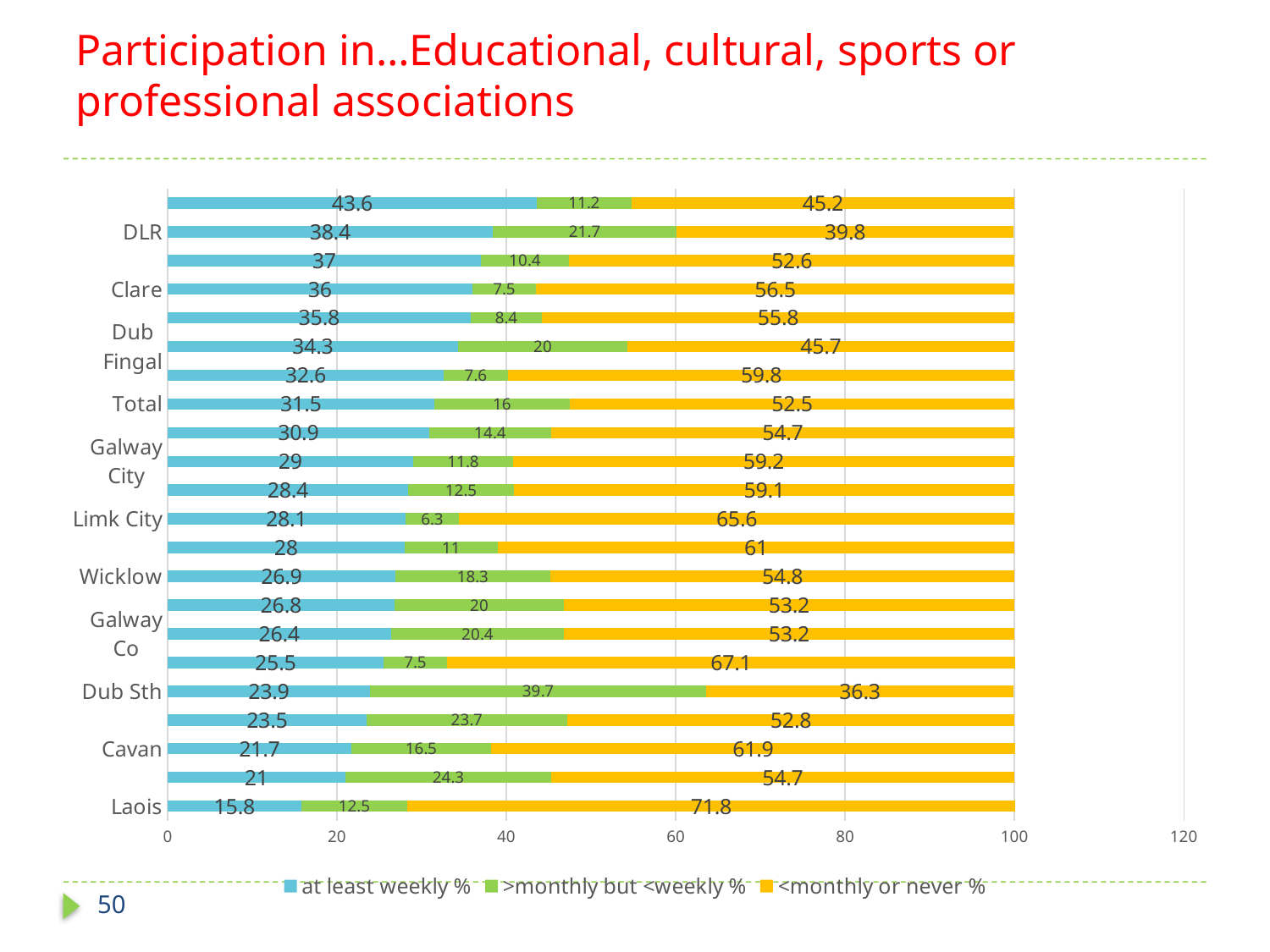
Which is larger, the 'at least weekly %' value for DLR or for Clare? DLR Which labelled category has the lowest 'at least weekly %' value? Laois How many bars are plotted in the chart? 22 What type of chart is shown on the slide? stacked bar chart Do the 'at least weekly %' values rise or fall going from the top bar to the bottom bar? fall What is the '>monthly but <weekly %' value for Dub Sth? 39.7 What is the '<monthly or never %' value for Limk City? 65.6 What is the difference between the '<monthly or never %' and 'at least weekly %' values for Laois? 56 What is the 'at least weekly %' value for Laois? 15.8 How many series does the legend list? 3 Which labelled category has the highest '<monthly or never %' value? Laois What is the 'at least weekly %' value for Total? 31.5